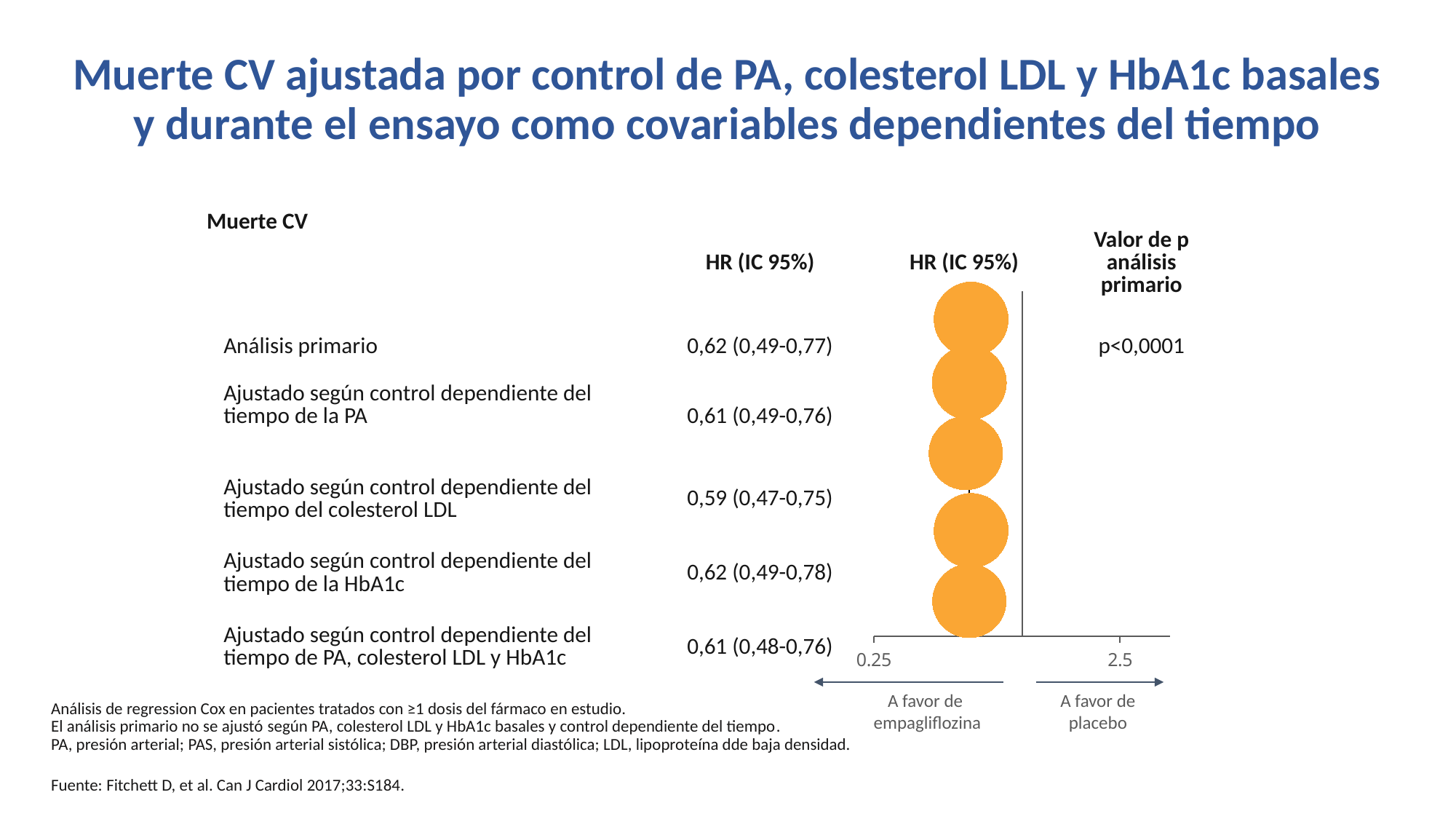
What is the HR (IC 95%) for the analysis adjusted for time-dependent control of LDL cholesterol (Ajustado según control dependiente del tiempo del colesterol LDL)? 0,59 (0,47-0,75) What is the HR (IC 95%) for the analysis adjusted for time-dependent control of HbA1c? 0,62 (0,49-0,78) What p-value is shown for the Análisis primario? p<0,0001 Which has the larger hazard ratio: the Análisis primario or the analysis adjusted for time-dependent LDL cholesterol control? Análisis primario What type of chart is shown on the slide? Forest plot What is the difference between the hazard ratio of the Análisis primario and the hazard ratio of the analysis adjusted for time-dependent LDL cholesterol control? 0,03 Which analysis row has the lowest hazard ratio? Ajustado según control dependiente del tiempo del colesterol LDL What is the HR (IC 95%) for the Análisis primario row? 0,62 (0,49-0,77) Is the hazard ratio for the analysis adjusted for time-dependent PA control greater or less than 2.5? less What does the left side of the horizontal axis favour, according to the label under the arrow? A favor de empagliflozina What is the HR (IC 95%) for the analysis adjusted for time-dependent control of PA, colesterol LDL y HbA1c? 0,61 (0,48-0,76) How many analysis rows (points) are plotted in the forest plot? 5